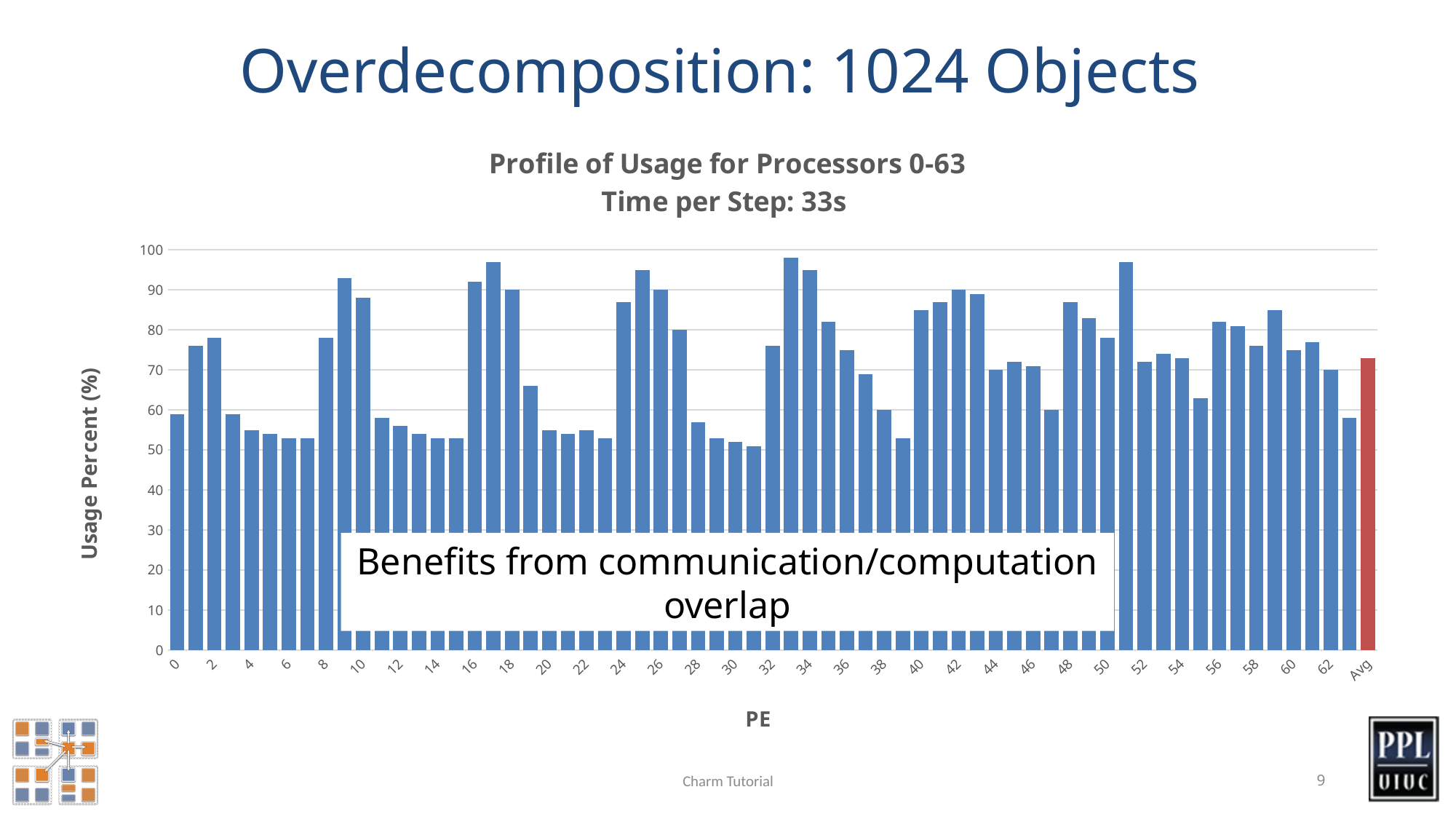
Is the value for PE 51 greater or less than 90? greater Which has a higher usage percent, PE 33 or PE 31? PE 33 Is the value for PE 33 greater or less than 90? greater How many processors are profiled in the chart, excluding the Avg bar? 64 Is the value for PE 2 greater or less than 80? less Which has a higher usage percent, PE 9 or PE 10? PE 9 What is the label of the y axis? Usage Percent (%) What kind of chart is shown on the slide? bar chart What is the title of the chart? Profile of Usage for Processors 0-63 Time per Step: 33s